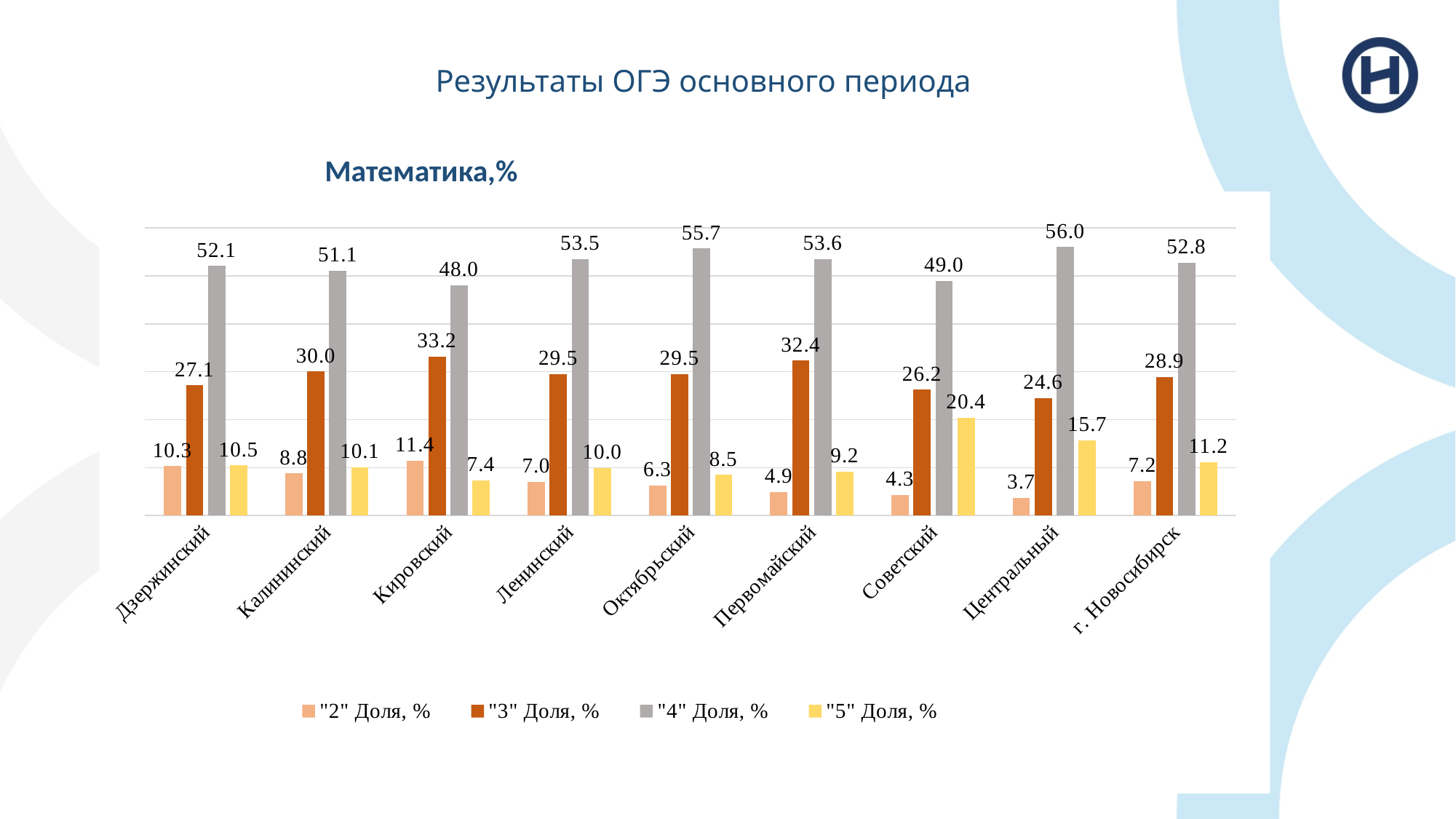
What is the difference between the "5" Доля, % values for Советский and Центральный? 4.7 What is the "5" Доля, % value for Центральный? 15.7 How many categories are shown on the x axis? 9 Which is larger: the "3" Доля, % value for Калининский or for Дзержинский? Калининский What is the "3" Доля, % value for г. Новосибирск? 28.9 How many series does the legend list? 4 Which category has the lowest "2" Доля, % value? Центральный What is the "2" Доля, % value for Первомайский? 4.9 What kind of chart is shown on the slide? bar chart What is the "4" Доля, % value for Кировский? 48.0 Which category has the highest "5" Доля, % value? Советский Which category has the highest "3" Доля, % value? Кировский